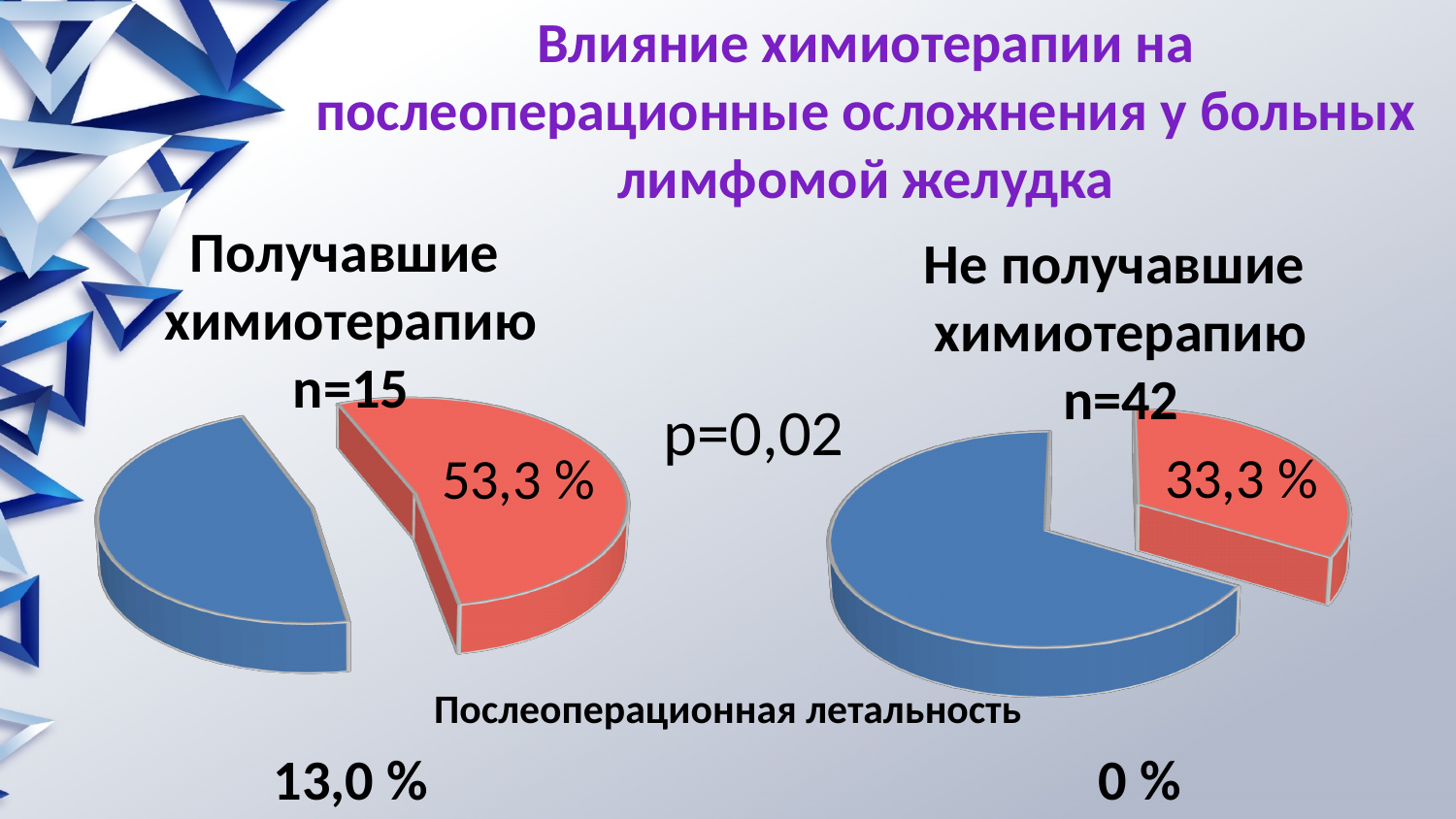
What is the sample size (n) given for the right pie chart (Не получавшие химиотерапию)? n=42 On the right pie chart (Не получавшие химиотерапию), which slice is larger, the red one or the blue one? The blue one Which pie chart has the larger labelled red slice, the left one (Получавшие химиотерапию) or the right one (Не получавшие химиотерапию)? The left one (Получавшие химиотерапию) How many pie charts are on the slide? 2 What is the difference between the red slice values of the left pie chart (53,3 %) and the right pie chart (33,3 %)? 20,0 % On the left pie chart (Получавшие химиотерапию), which slice is larger, the red one or the blue one? The red one On the left pie chart (Получавшие химиотерапию), what percentage is shown on the red slice? 53,3 % What is the sample size (n) given for the left pie chart (Получавшие химиотерапию)? n=15 How many slices does the left pie chart (Получавшие химиотерапию) have? 2 What kind of chart is used on this slide? Pie chart On the right pie chart (Не получавшие химиотерапию), what percentage is shown on the red slice? 33,3 %